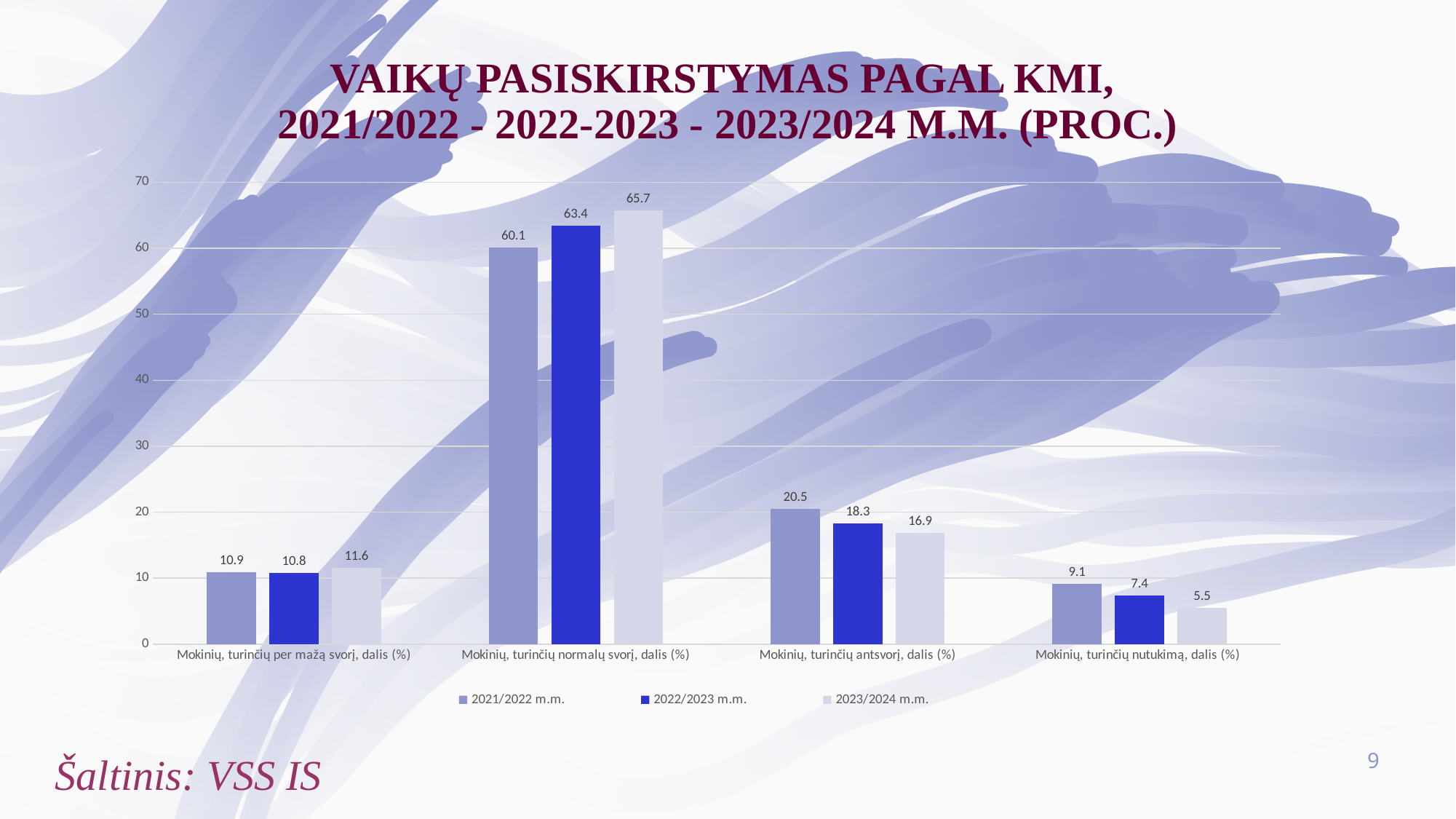
Is the 2022/2023 m.m. value for 'Mokinių, turinčių nutukimą, dalis (%)' greater or less than 10? less Do the values for 'Mokinių, turinčių nutukimą, dalis (%)' rise or fall from 2021/2022 m.m. to 2023/2024 m.m.? fall What is the value for 'Mokinių, turinčių nutukimą, dalis (%)' in the 2021/2022 m.m. series? 9.1 Which category has the lowest value in the 2023/2024 m.m. series? Mokinių, turinčių nutukimą, dalis (%) Which category has the highest value in the 2021/2022 m.m. series? Mokinių, turinčių normalų svorį, dalis (%) How many categories are shown on the x axis? 4 What is the value for 'Mokinių, turinčių antsvorį, dalis (%)' in the 2022/2023 m.m. series? 18.3 What kind of chart is shown on the slide? bar chart What is the value for 'Mokinių, turinčių normalų svorį, dalis (%)' in the 2023/2024 m.m. series? 65.7 Which is larger for 'Mokinių, turinčių antsvorį, dalis (%)': the 2021/2022 m.m. value or the 2023/2024 m.m. value? 2021/2022 m.m. What is the difference between the 2023/2024 m.m. and 2021/2022 m.m. values for 'Mokinių, turinčių normalų svorį, dalis (%)'? 5.6 How many series does the legend list? 3